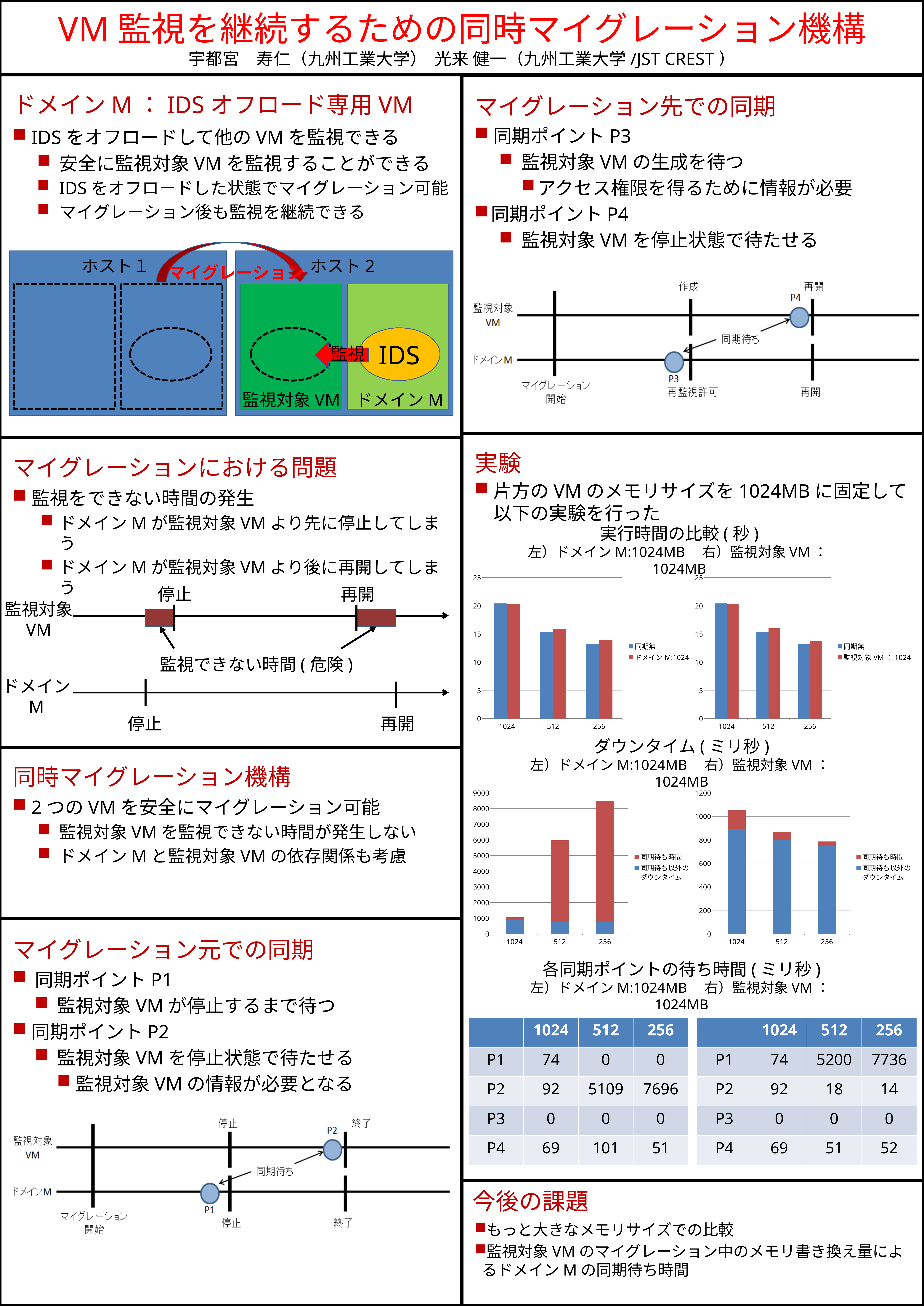
In the left 実行時間の比較 chart (ドメインM:1024MB), is the 同期無 value for 1024 greater or less than 15? greater In the left ダウンタイム chart (ドメインM:1024MB), is the total for 512 greater or less than 5000? greater In the left ダウンタイム chart (ドメインM:1024MB), which category has the lowest total downtime? 1024 In the right ダウンタイム chart (監視対象VM:1024MB), is the total for 256 greater or less than 1000? less In the left ダウンタイム chart (ドメインM:1024MB), which category has the highest total downtime? 256 How many categories are shown on the x axis of the left 実行時間の比較 chart (ドメインM:1024MB)? 3 In the right 実行時間の比較 chart (監視対象VM:1024MB), which is larger for 同期無: 512 or 256? 512 How many series does the legend of the right 実行時間の比較 chart (監視対象VM:1024MB) list? 2 What kind of chart is the left 実行時間の比較 chart (ドメインM:1024MB)? bar chart What are the two legend entries of the left ダウンタイム chart (ドメインM:1024MB)? 同期待ち時間, 同期待ち以外のダウンタイム In the left 実行時間の比較 chart (ドメインM:1024MB), do the 同期無 values rise or fall from 1024 to 256 along the x axis? fall